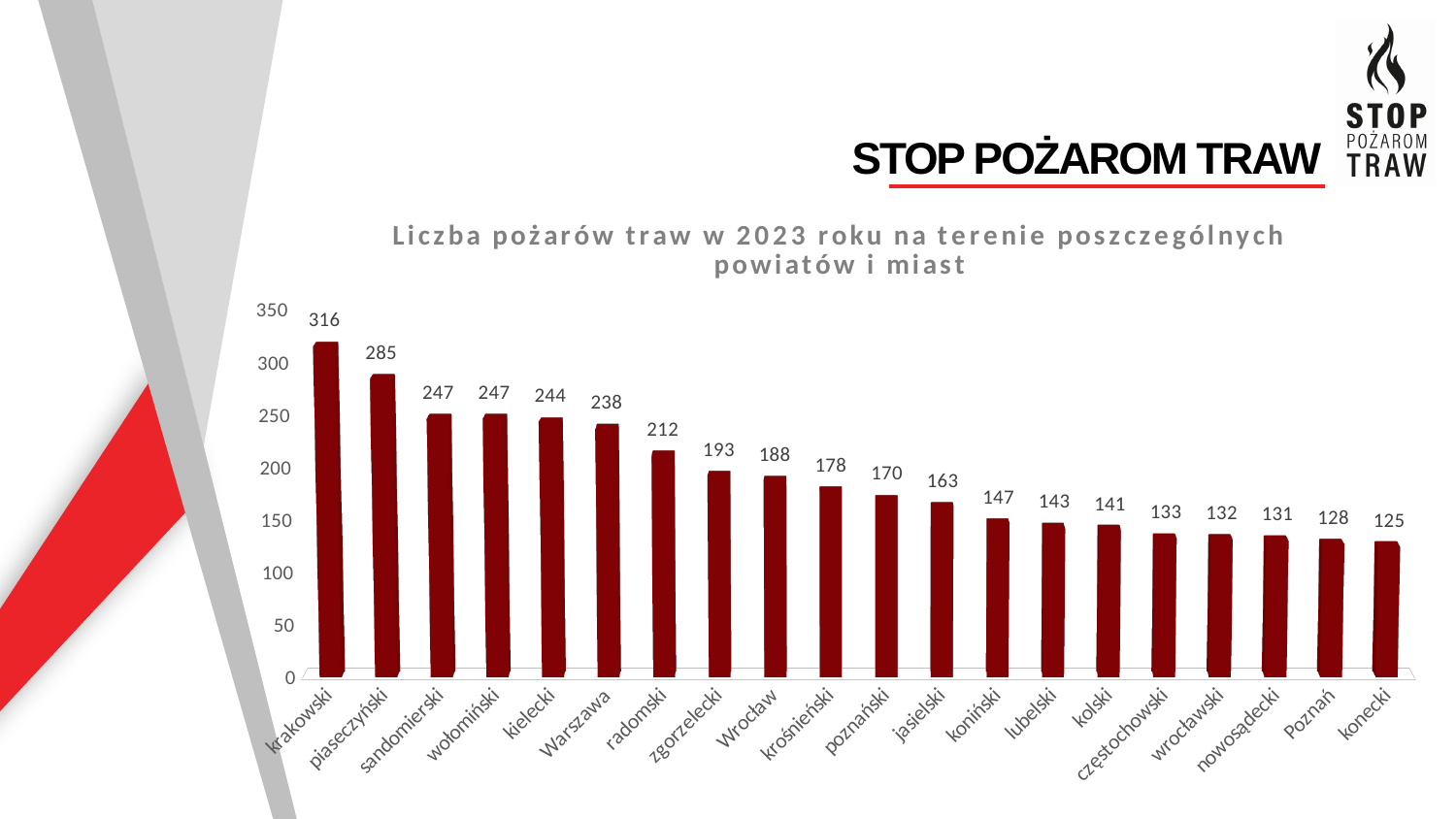
What is the value shown for Wrocław? 188 What is the difference between the values for Warszawa and Poznań? 110 What is the difference between the values for krakowski and piaseczyński? 31 Do the values rise or fall from left to right along the x axis? fall How many powiats and cities are shown on the chart? 20 What is the value shown for Warszawa? 238 Is the value for koniński greater or less than 150? less Which has a larger value, radomski or zgorzelecki? radomski How many grass fires were recorded for krakowski in 2023? 316 What kind of chart is shown on the slide? bar chart Which powiat or city has the highest number of grass fires? krakowski Which powiat or city has the lowest number of grass fires? konecki